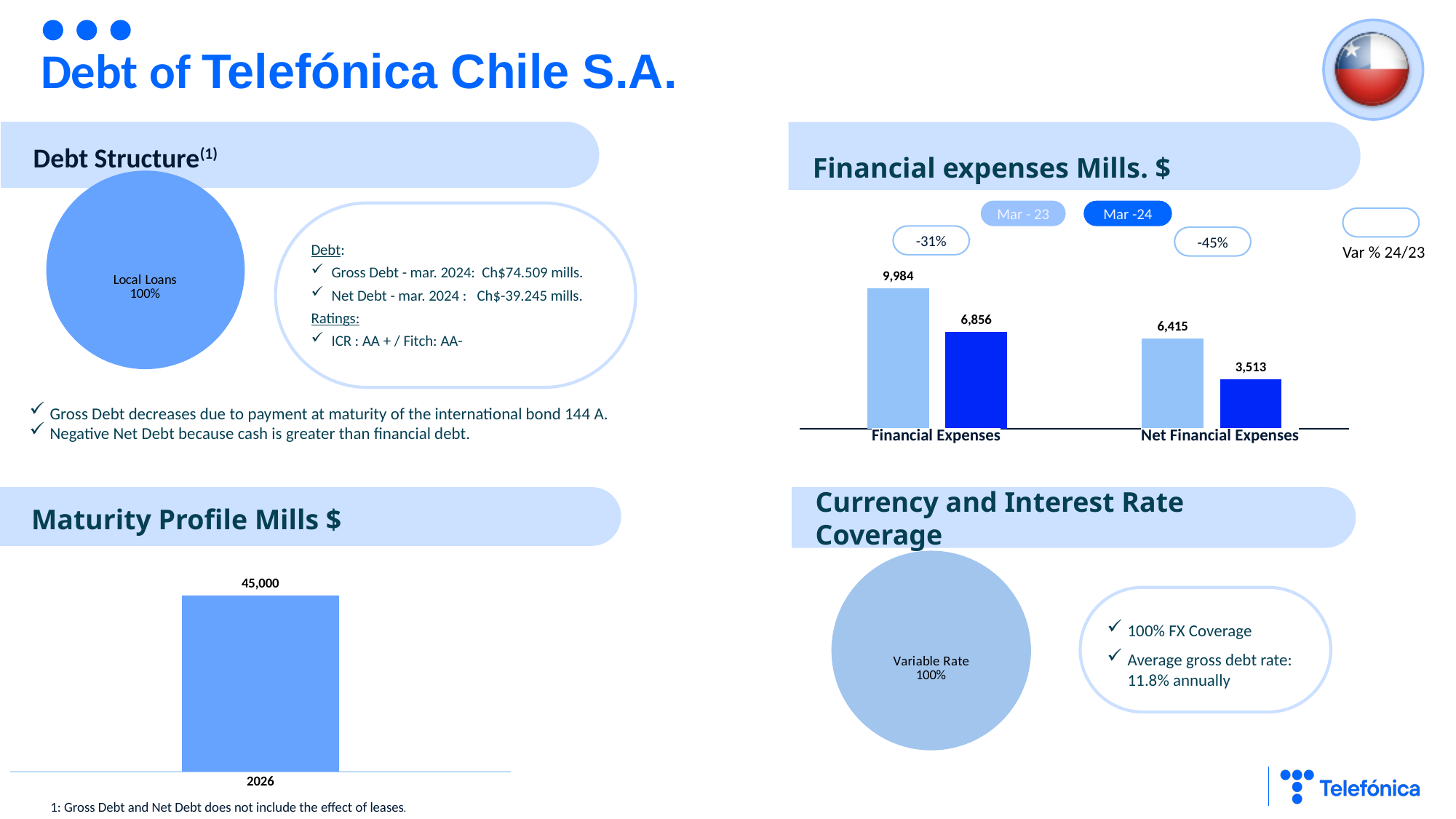
In the Financial expenses Mills. $ chart, what is the value for Net Financial Expenses in Mar-24? 3,513 In the Financial expenses Mills. $ chart, which is larger: Financial Expenses in Mar-24 or Net Financial Expenses in Mar-23? Financial Expenses in Mar-24 In the Financial expenses Mills. $ chart, how many series does the legend list? 2 In the Financial expenses Mills. $ chart, what is the value for Financial Expenses in Mar-24? 6,856 What kind of chart is the Maturity Profile Mills $ chart? Bar chart In the Financial expenses Mills. $ chart, which bar has the lowest value? Net Financial Expenses, Mar-24 In the Financial expenses Mills. $ chart, what is the value for Financial Expenses in Mar-23? 9,984 In the Financial expenses Mills. $ chart, what is the difference between Net Financial Expenses in Mar-23 and Mar-24? 2,902 In the Financial expenses Mills. $ chart, what is the Var % 24/23 shown for Net Financial Expenses? -45% In the Maturity Profile Mills $ chart, what is the value for 2026? 45,000 In the Currency and Interest Rate Coverage pie chart, what share does Variable Rate have? 100% In the Financial expenses Mills. $ chart, what is the difference between Financial Expenses in Mar-23 and Mar-24? 3,128